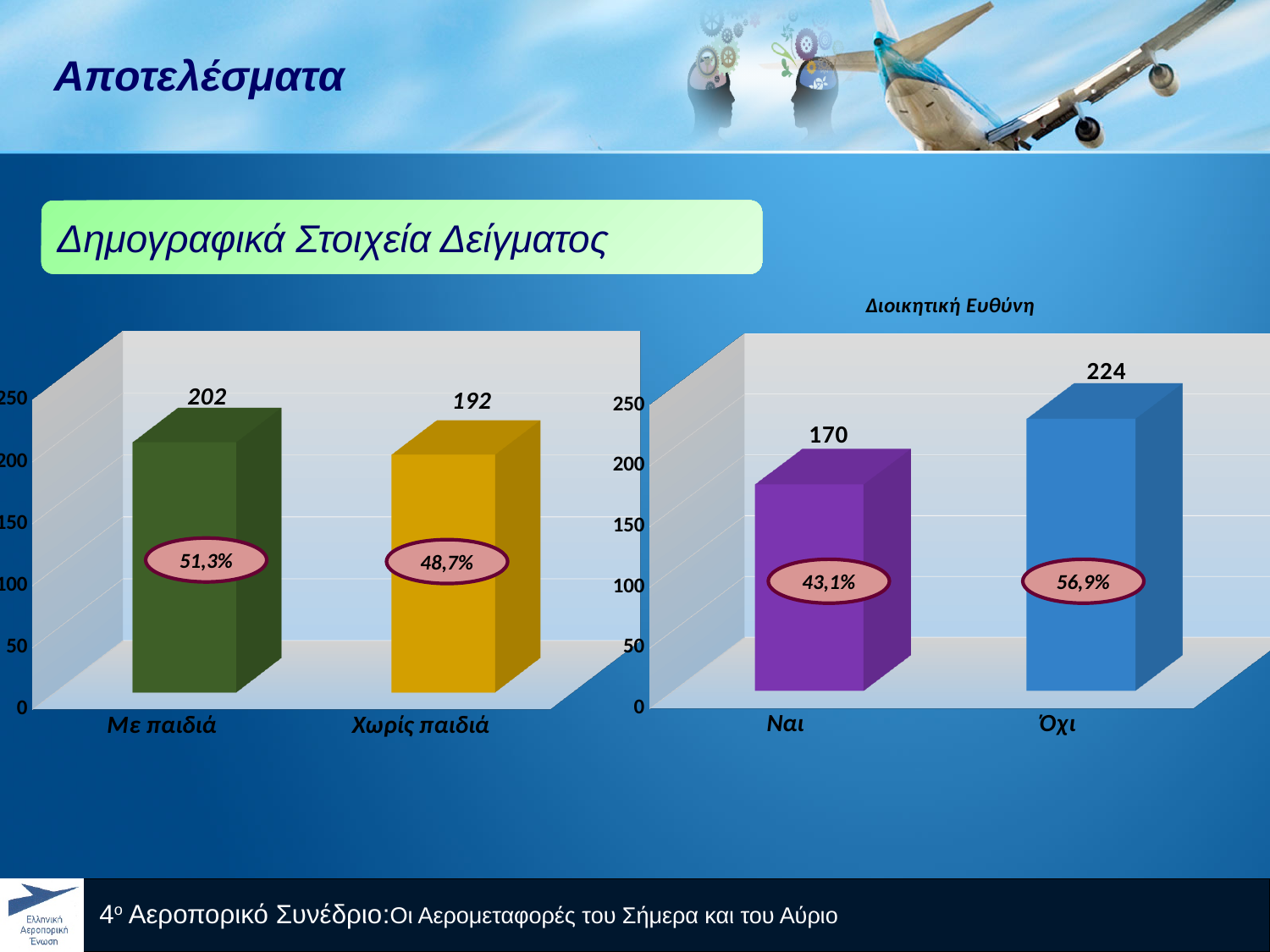
In the chart titled Διοικητική Ευθύνη, which category has the highest value? Όχι In the chart titled Διοικητική Ευθύνη, what percentage is shown on the Όχι bar? 56,9% In the chart titled Διοικητική Ευθύνη, is the value for Ναι greater or less than 200? less In the left chart, what is the difference between the values for Με παιδιά and Χωρίς παιδιά? 10 In the left chart, what is the value for Χωρίς παιδιά? 192 In the chart titled Διοικητική Ευθύνη, what is the difference between the values for Όχι and Ναι? 54 In the left chart, what is the value for Με παιδιά? 202 In the left chart, what percentage is shown on the Με παιδιά bar? 51,3% What kind of chart is the chart titled Διοικητική Ευθύνη? bar chart In the left chart, which category has the lowest value? Χωρίς παιδιά In the chart titled Διοικητική Ευθύνη, what is the value for Ναι? 170 In the chart titled Διοικητική Ευθύνη, what is the value for Όχι? 224